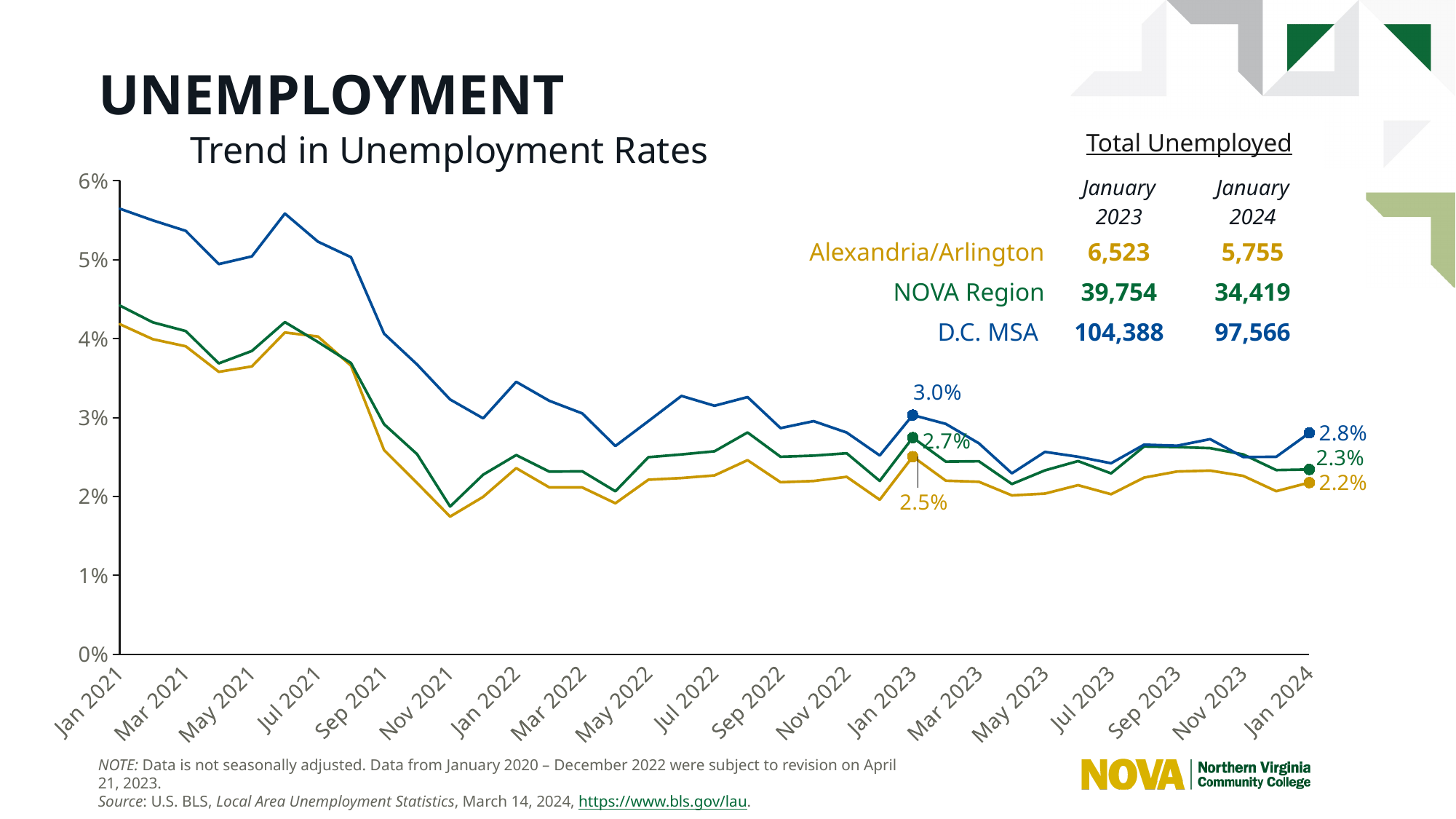
How many series are plotted in the chart? 3 What was the Alexandria/Arlington unemployment rate in January 2024? 2.2% What was the NOVA Region unemployment rate in January 2023? 2.7% Is the D.C. MSA unemployment rate in January 2021 greater or less than 5%? greater Which series had the lowest unemployment rate in January 2024? Alexandria/Arlington In January 2024, which was higher: the NOVA Region rate or the Alexandria/Arlington rate? NOVA Region Which series had the highest unemployment rate in January 2023? D.C. MSA What was the D.C. MSA unemployment rate in January 2024? 2.8% By how many percentage points did the D.C. MSA unemployment rate change from January 2023 to January 2024? 0.2 percentage points Overall, do the unemployment rates rise or fall from January 2021 to January 2024? Fall What is the title of the chart? Trend in Unemployment Rates What kind of chart is shown on the slide? Line chart